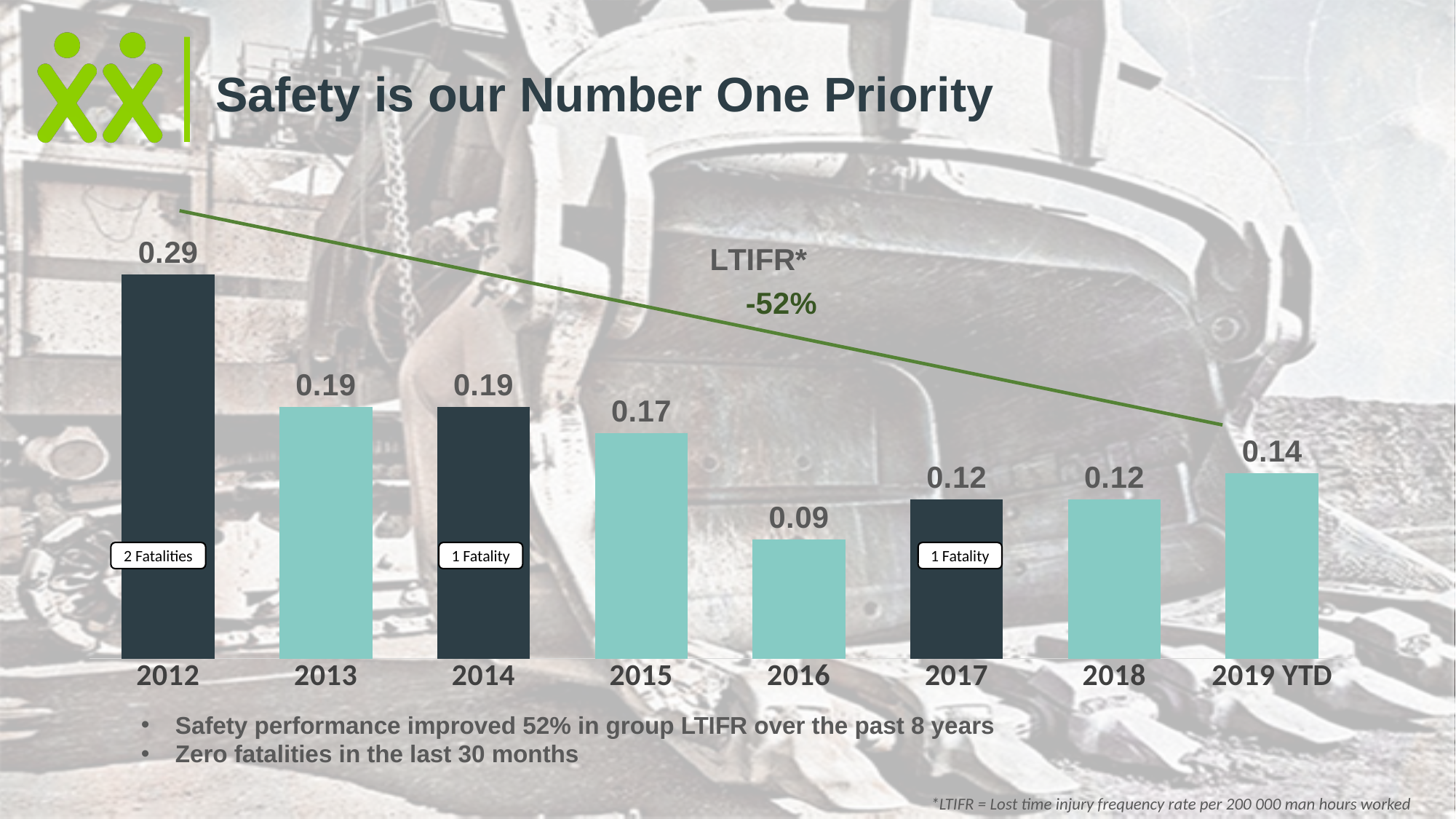
What kind of chart is shown on the slide? Bar chart Which year has the lowest LTIFR? 2016 How many fatalities are labelled on the 2012 bar? 2 Fatalities Which year has the highest LTIFR? 2012 What is the LTIFR value for 2019 YTD? 0.14 Which is larger, the LTIFR for 2015 or for 2018? 2015 How many years are shown on the x axis of the chart? 8 What percentage change in LTIFR is shown next to the trend line? -52% Do the LTIFR values generally rise or fall from 2012 to 2019 YTD? Fall What is the difference between the LTIFR in 2012 and in 2019 YTD? 0.15 What is the LTIFR value for 2016? 0.09 What is the LTIFR value for 2012? 0.29